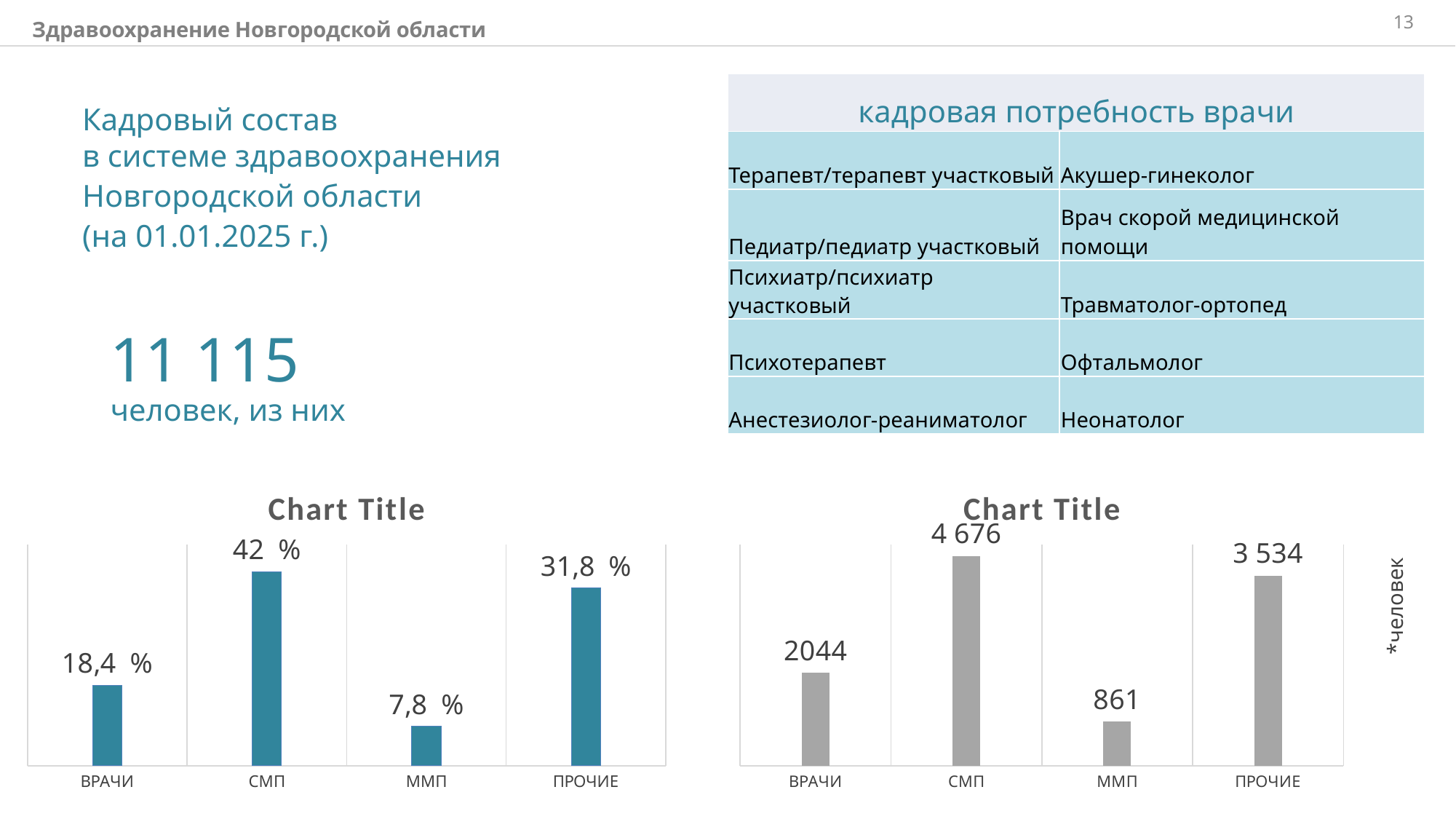
In the right chart, what is the value for ВРАЧИ? 2044 In the left chart, which is larger, the value for ВРАЧИ or the value for ПРОЧИЕ? ПРОЧИЕ What colour are the bars in the right chart? grey In the right chart, which category has the highest value? СМП How many categories are shown in the left chart? 4 In the left chart, what is the value for СМП? 42 % What kind of chart is the right chart? bar chart What is the title of the left chart? Chart Title In the right chart, what is the difference between the values for СМП and ММП? 3 815 In the right chart, what is the value for ПРОЧИЕ? 3 534 In the left chart, which category has the lowest value? ММП In the left chart, what is the value for ММП? 7,8 %